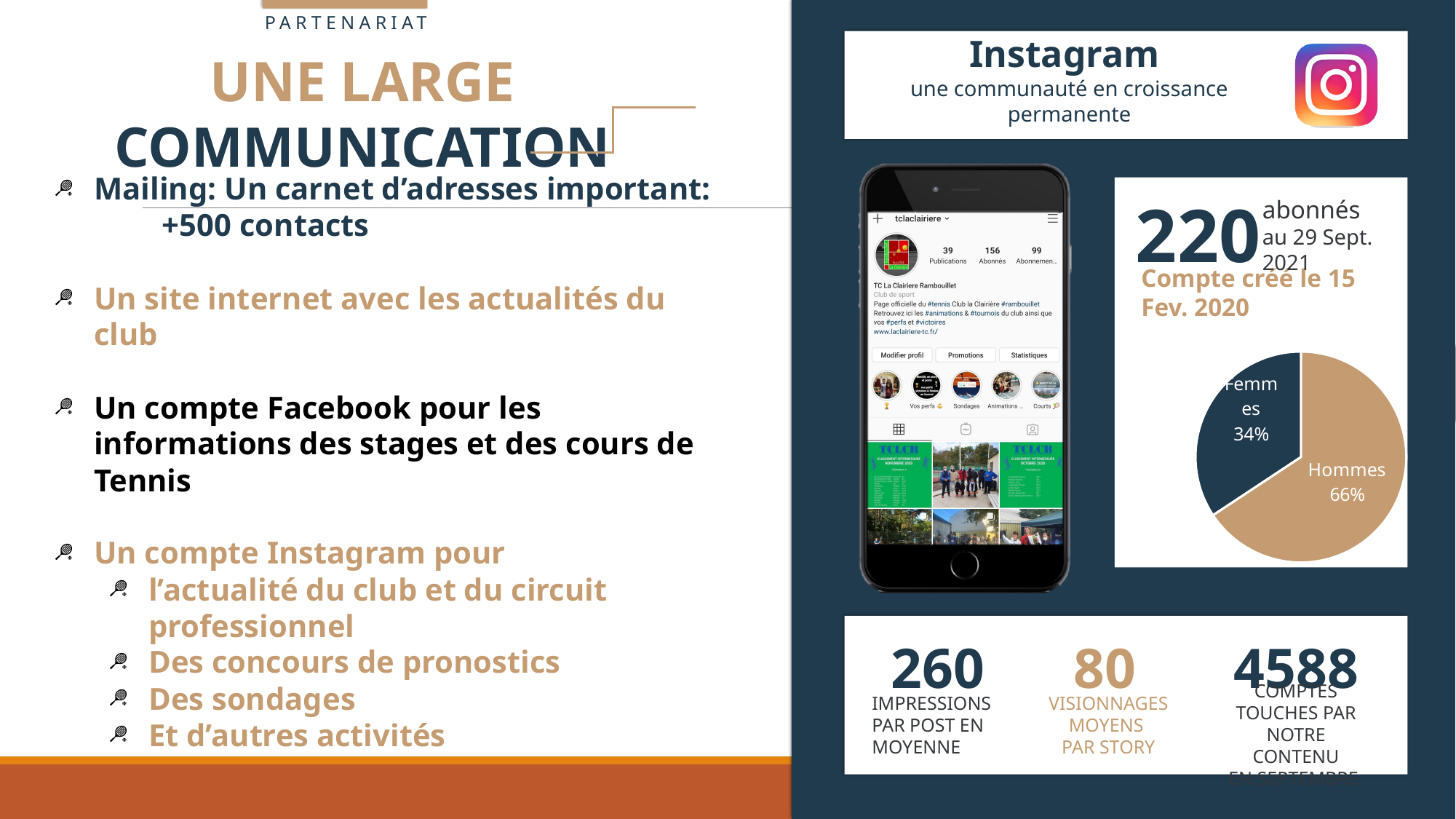
Which slice of the pie chart is the largest? Hommes What colour is the Hommes slice of the pie chart? tan/brown Is the Femmes share in the pie chart greater or less than 50%? less Which slice of the pie chart is the smallest? Femmes How many slices does the pie chart have? 2 What is the difference in percentage points between the Hommes and Femmes slices of the pie chart? 32 Which is larger in the pie chart, Hommes or Femmes? Hommes What share of the pie chart is labelled Femmes? 34% What kind of chart is shown on the slide? pie chart What share of the pie chart is labelled Hommes? 66% What colour is the Femmes slice of the pie chart? dark blue